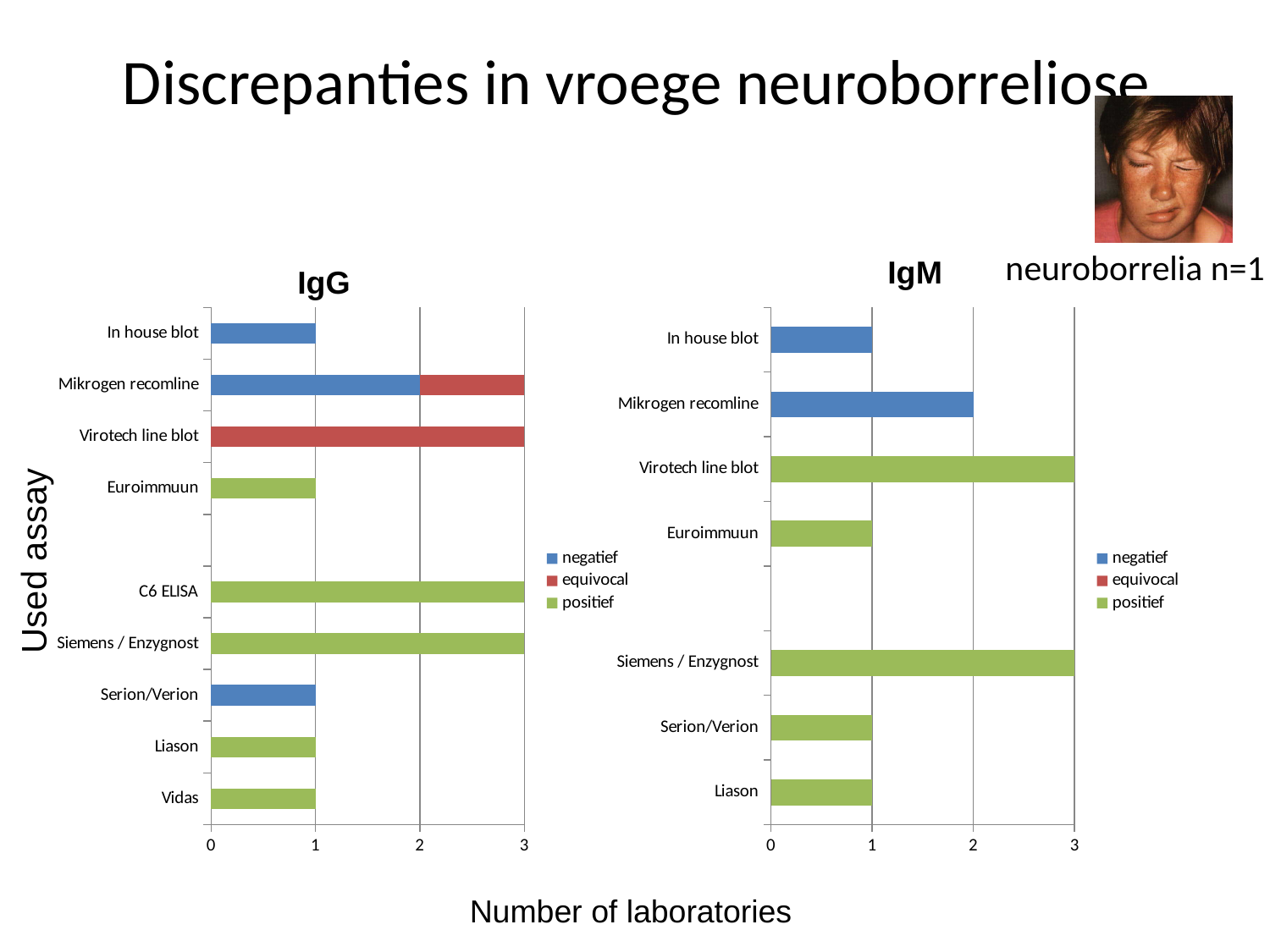
In the IgM chart, what is the positief value for Virotech line blot? 3 In the IgM chart, which series does the bar for In house blot belong to? negatief In the IgG chart, what type of chart is shown? bar chart In the IgG chart, which is larger, the bar for Siemens / Enzygnost or the bar for Vidas? Siemens / Enzygnost In the IgM chart, what is the negatief value for Mikrogen recomline? 2 In the IgG chart, what is the negatief value for Mikrogen recomline? 2 In the IgG chart, what is the total of the stacked bar for Mikrogen recomline? 3 In the IgM chart, what is the difference between the positief value for Siemens / Enzygnost and the positief value for Liason? 2 What is the x-axis label shared by the two charts? Number of laboratories In the IgG chart, what is the equivocal value for Virotech line blot? 3 In the IgG chart, what is the positief value for C6 ELISA? 3 In the IgG chart, how many series does the legend list? 3